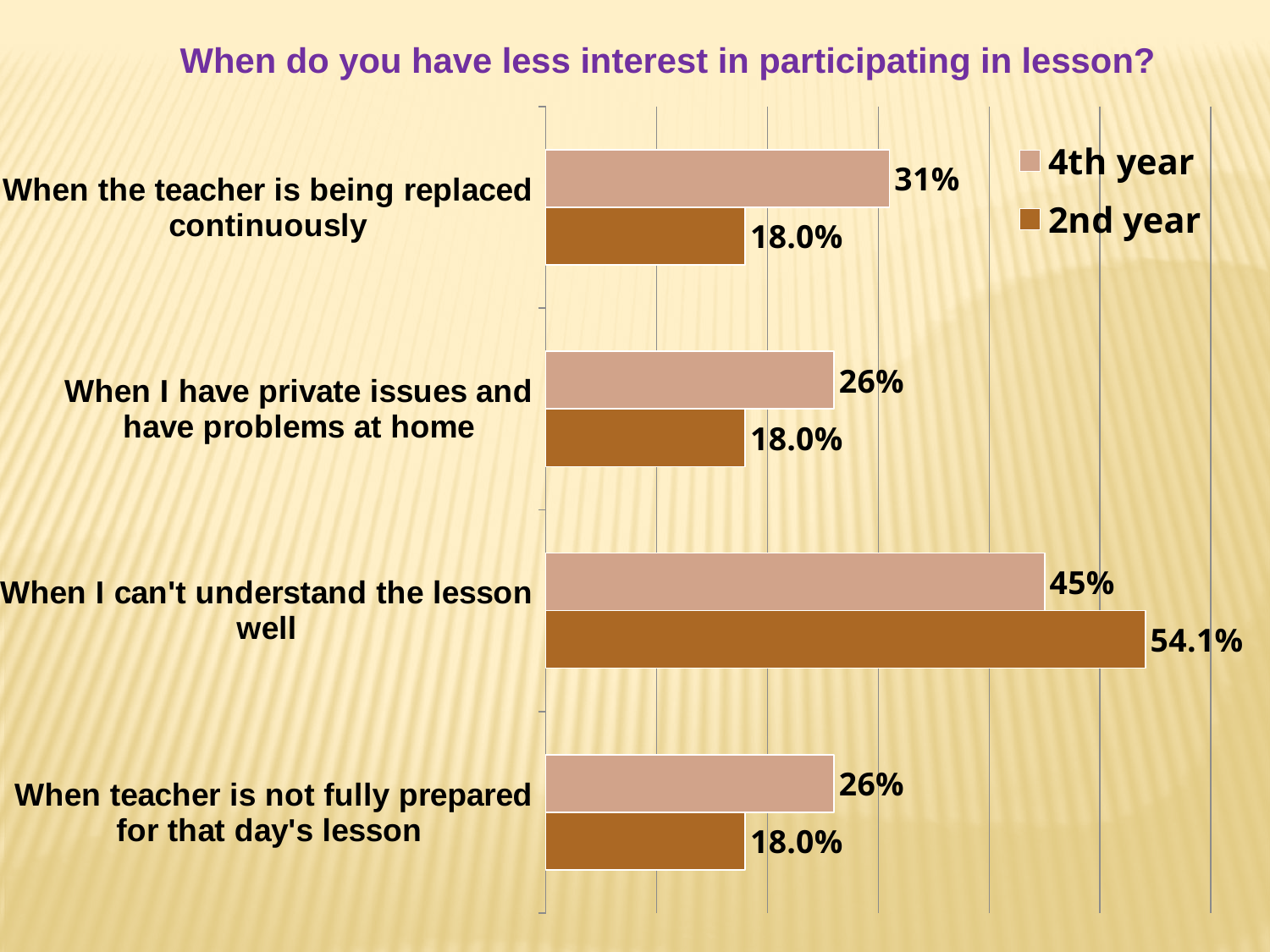
Which category has the highest 2nd year value? When I can't understand the lesson well What is the difference between the 2nd year and 4th year values for "When I can't understand the lesson well"? 9.1% How many categories are shown in the chart? 4 What is the difference between the 4th year and 2nd year values for "When the teacher is being replaced continuously"? 13% How many series does the legend list? 2 What is the 4th year value for "When I have private issues and have problems at home"? 26% What is the 2nd year value for "When I can't understand the lesson well"? 54.1% For "When I have private issues and have problems at home", which is larger: the 4th year value or the 2nd year value? 4th year What kind of chart is shown on the slide? Bar chart What is the 4th year value for "When the teacher is being replaced continuously"? 31% What is the 2nd year value for "When teacher is not fully prepared for that day's lesson"? 18.0% Which category has the highest 4th year value? When I can't understand the lesson well